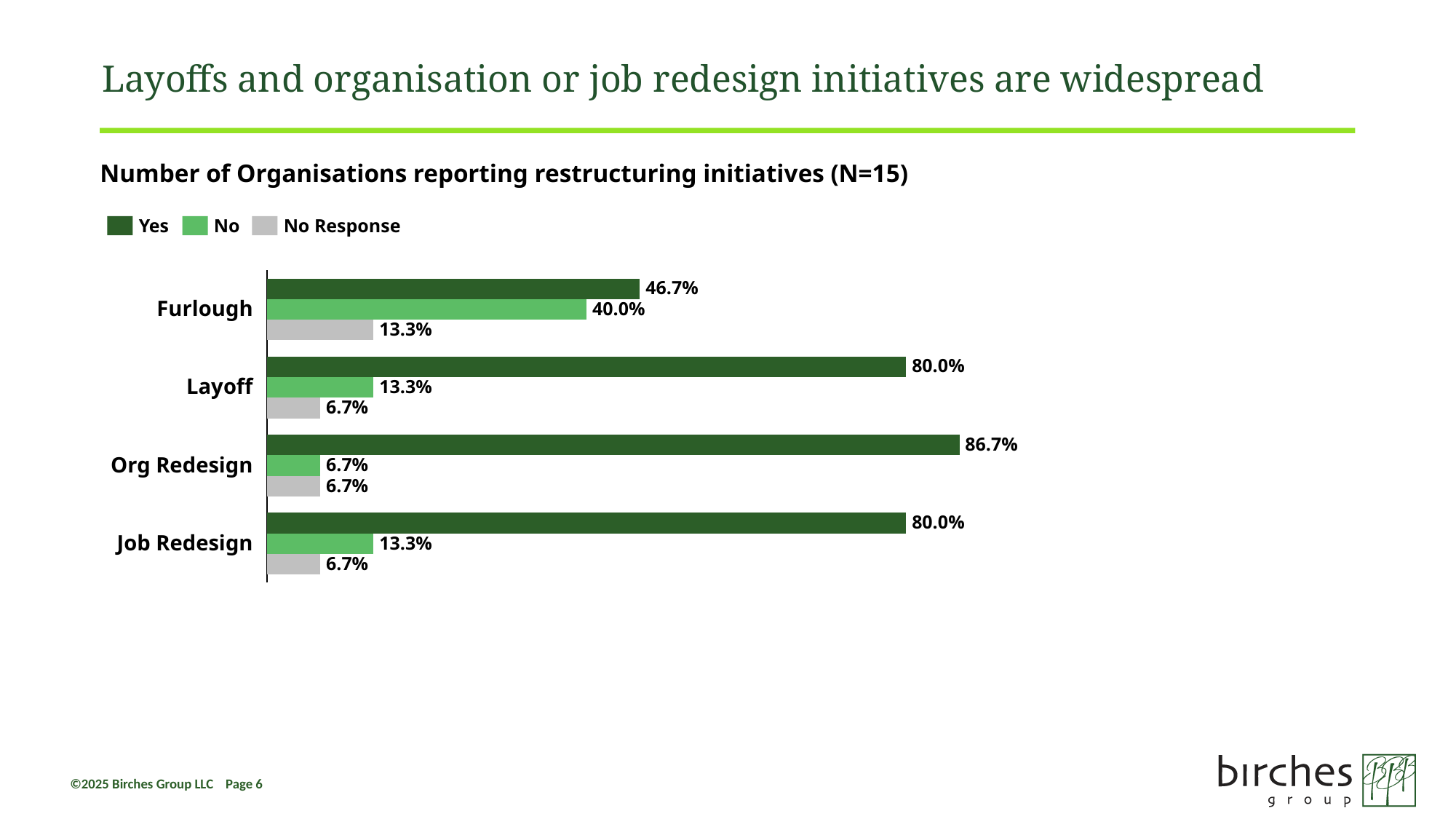
Which category has the highest No value? Furlough What is the No value for Layoff? 13.3% Which category has the lowest Yes value? Furlough Which is larger: the No value for Furlough or the No value for Layoff? Furlough What is the No Response value for Org Redesign? 6.7% What is the difference between the Yes values for Org Redesign and Furlough? 40.0% What is the Yes value for Job Redesign? 80.0% What is the Yes value for Furlough? 46.7% How many categories are shown on the chart? 4 What kind of chart is shown on the slide? Bar chart Which category has the highest Yes value? Org Redesign How many series does the legend list? 3